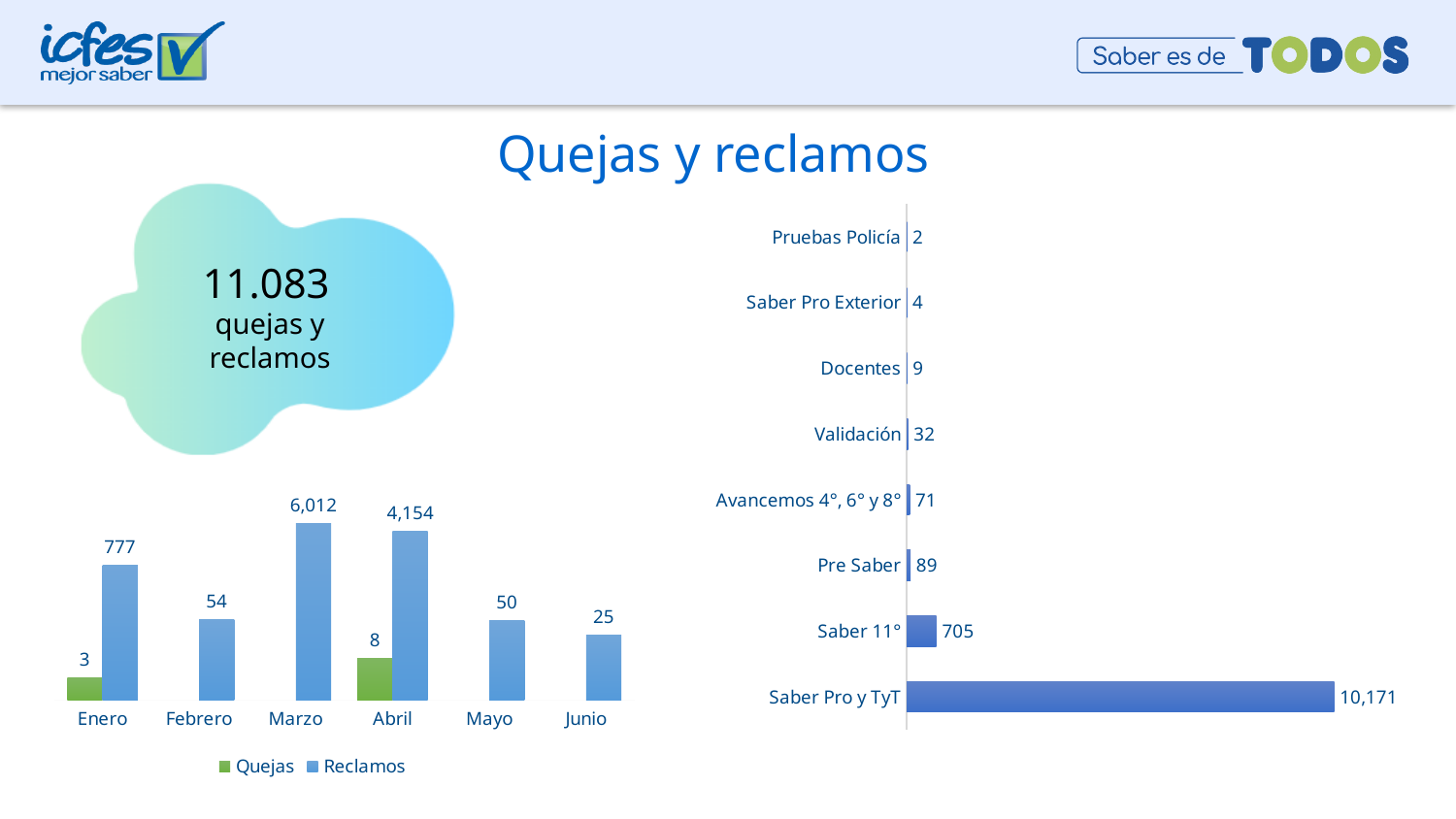
In the bar chart on the right of the slide, which category has the lowest value? Pruebas Policía In the bar chart on the right of the slide, what is the value for Validación? 32 In the bar chart on the left of the slide, which month has the lowest Reclamos value? Junio In the bar chart on the left of the slide, which month has the highest Reclamos value? Marzo In the bar chart on the right of the slide, what is the value for Saber 11°? 705 In the bar chart on the right of the slide, which category has the highest value? Saber Pro y TyT What kind of chart is shown on the right of the slide? Bar chart In the bar chart on the left of the slide, what is the difference between the Reclamos values for Marzo and Abril? 1,858 In the bar chart on the left of the slide, how many months are shown on the x axis? 6 In the bar chart on the left of the slide, what is the value of Reclamos for Marzo? 6,012 In the bar chart on the left of the slide, what is the value of Quejas for Abril? 8 In the bar chart on the left of the slide, how many series does the legend list? 2